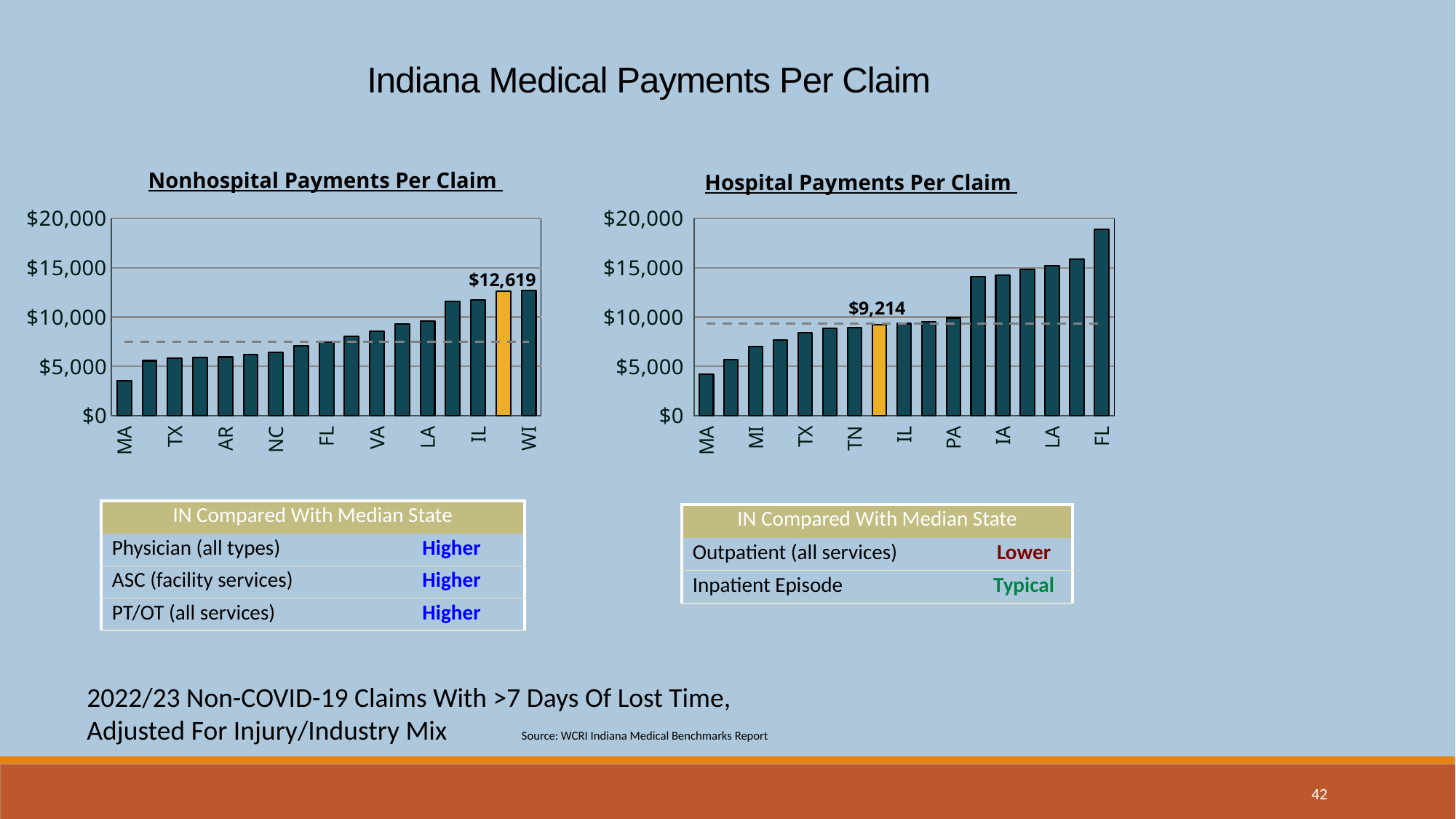
In the Hospital Payments Per Claim chart, which is larger, the value for FL or the value for TX? FL In the Hospital Payments Per Claim chart, which labeled state has the lowest value? MA In the Hospital Payments Per Claim chart, what value is printed on the highlighted (yellow) bar? $9,214 What is the title of the chart on the left side of the slide? Nonhospital Payments Per Claim In the Nonhospital Payments Per Claim chart, is the value for MA greater or less than $5,000? less In the Nonhospital Payments Per Claim chart, what value is printed on the highlighted (yellow) bar? $12,619 In the Hospital Payments Per Claim chart, do the values rise or fall from left to right along the x axis? rise In the Hospital Payments Per Claim chart, is the value for FL greater or less than $15,000? greater What kind of chart is the Nonhospital Payments Per Claim chart? bar chart How many state labels are shown on the x axis of the Hospital Payments Per Claim chart? 9 In the Nonhospital Payments Per Claim chart, which labeled state has the highest value? WI In the Nonhospital Payments Per Claim chart, which is larger, the value for IL or the value for MA? IL